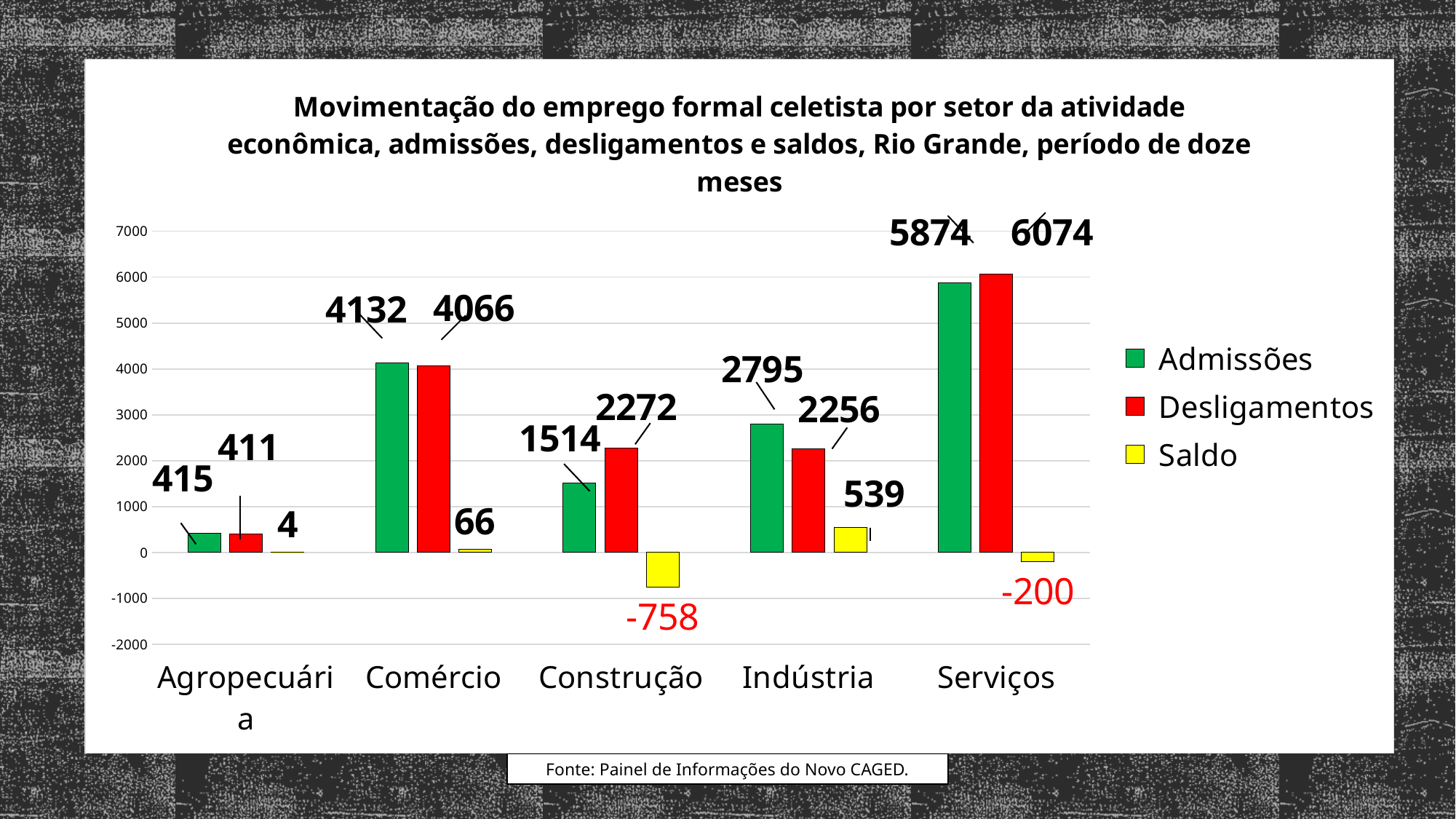
How many series does the legend list? 3 What is the Admissões value for Comércio? 4132 Which is larger for Construção, Admissões or Desligamentos? Desligamentos What kind of chart is shown on the slide? bar chart Is the Admissões value for Serviços greater or less than 5000? greater Which sector has the lowest Desligamentos value? Agropecuária What is the Saldo value for Construção? -758 What is the Saldo value for Indústria? 539 What is the difference between Admissões and Desligamentos for Indústria? 539 Which sector has the highest Admissões value? Serviços How many sectors are shown on the x axis? 5 What is the Desligamentos value for Serviços? 6074